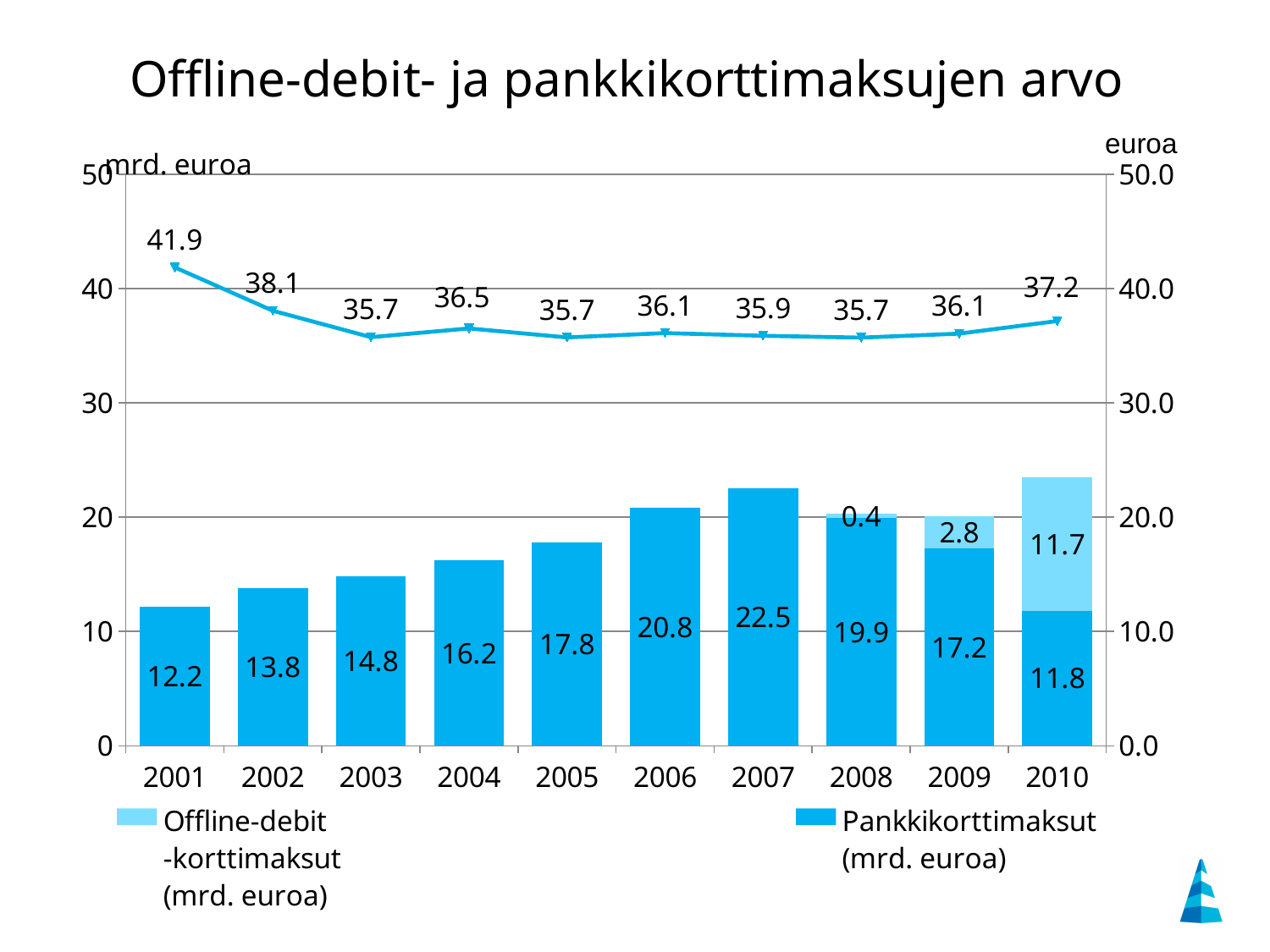
What is the title of the chart? Offline-debit- ja pankkikorttimaksujen arvo What is the value of Offline-debit-korttimaksut (mrd. euroa) in 2010? 11.7 Which is larger, the Pankkikorttimaksut value for 2006 or for 2008? 2006 In which year is the Pankkikorttimaksut bar the lowest? 2010 What is the value of Pankkikorttimaksut (mrd. euroa) in 2007? 22.5 In which year is the Pankkikorttimaksut bar the highest? 2007 What is the total height of the stacked bar for 2010 (Pankkikorttimaksut plus Offline-debit-korttimaksut)? 23.5 What is the value shown on the line for 2001? 41.9 How many series does the legend list? 2 Do the Pankkikorttimaksut bars rise or fall from 2001 to 2007? rise How many years are shown on the x axis? 10 What is the difference between the Pankkikorttimaksut values for 2007 and 2001? 10.3